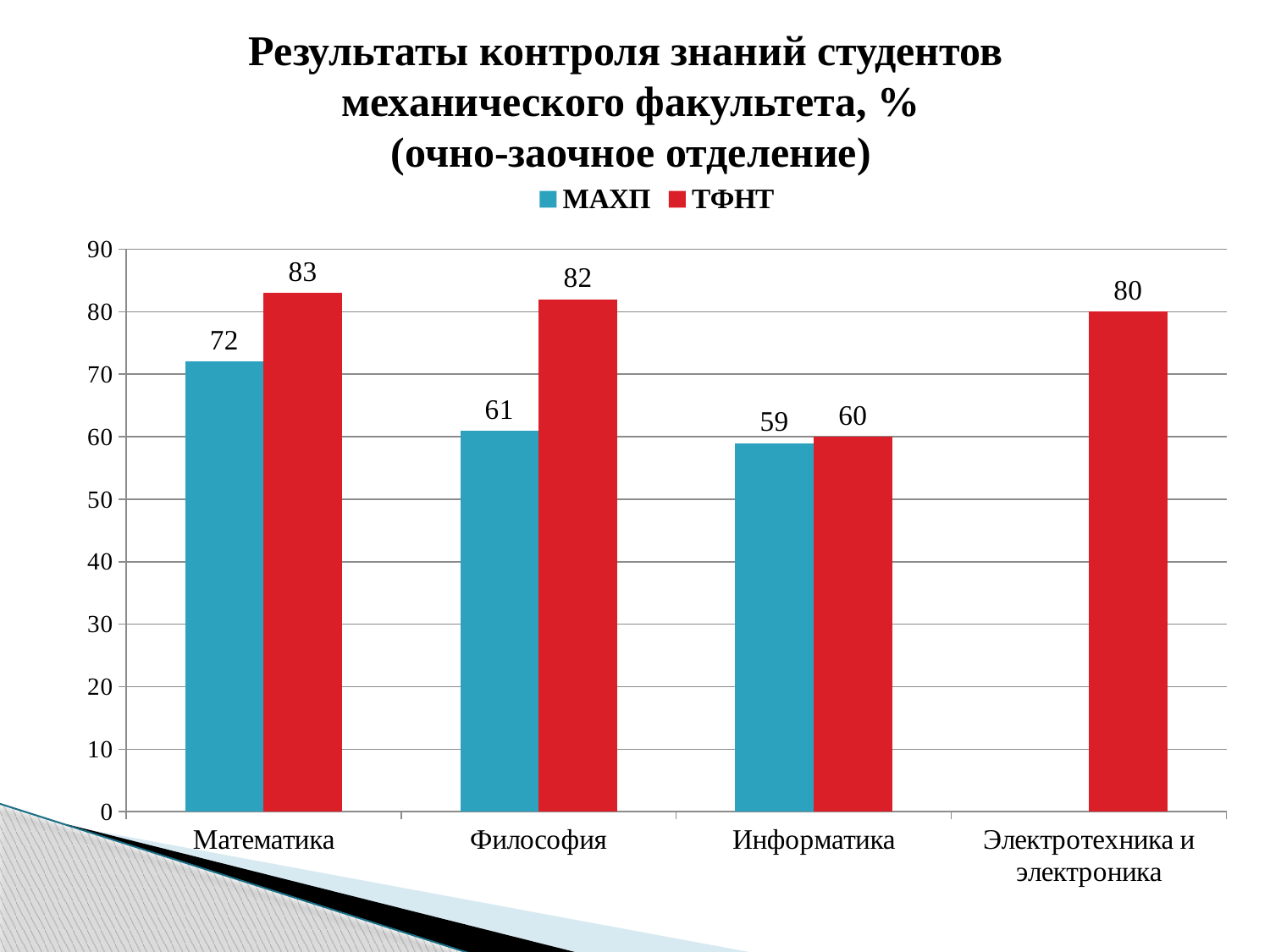
Is the value for МАХП in Философия greater or less than 70? less Which is larger in Информатика, МАХП or ТФНТ? ТФНТ How many categories are shown on the x axis? 4 What is the difference between ТФНТ and МАХП in Философия? 21 What is the value for ТФНТ in Философия? 82 Which colour represents the ТФНТ series? red Which category has the lowest value for МАХП? Информатика What is the value for МАХП in Математика? 72 What kind of chart is shown on the slide? bar chart What is the value for ТФНТ in Электротехника и электроника? 80 How many series does the legend list? 2 Which category has the highest value for ТФНТ? Математика